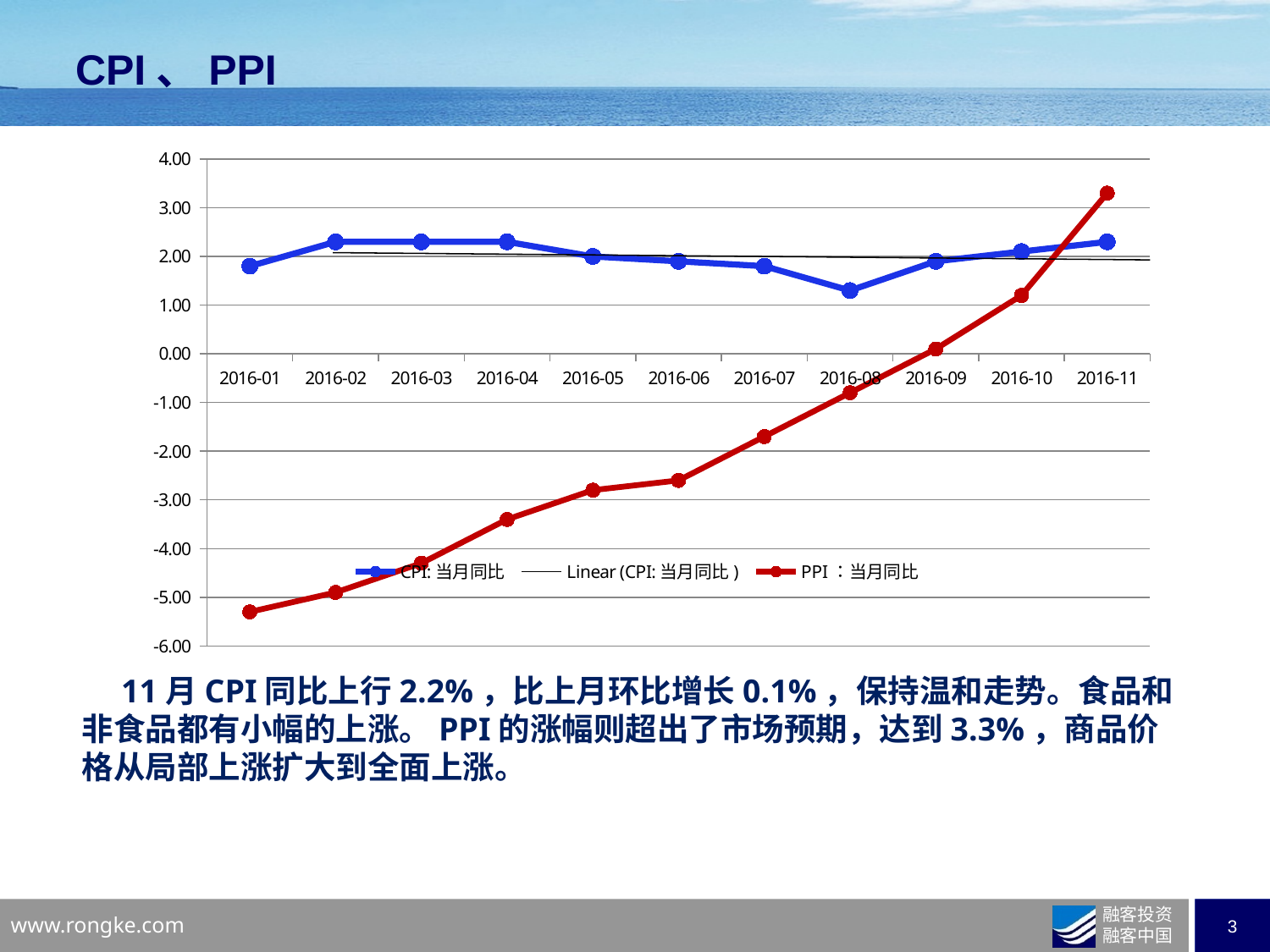
In which month is the CPI 当月同比 series at its lowest value? 2016-08 Is the PPI 当月同比 value for 2016-01 greater or less than -5.00? less Is the PPI 当月同比 value for 2016-07 greater or less than -1.00? less In which month does the PPI 当月同比 series reach its highest value? 2016-11 Does the PPI 当月同比 series rise or fall from 2016-01 to 2016-11? rise What colour is the line for the PPI 当月同比 series? red Is the PPI 当月同比 value for 2016-11 greater or less than 3.00? greater How many months are plotted along the x axis? 11 In 2016-01, which series has the larger value, CPI 当月同比 or PPI 当月同比? CPI 当月同比 In which month is the PPI 当月同比 series at its lowest value? 2016-01 What kind of chart is shown on the slide? line chart How many entries does the legend list? 3